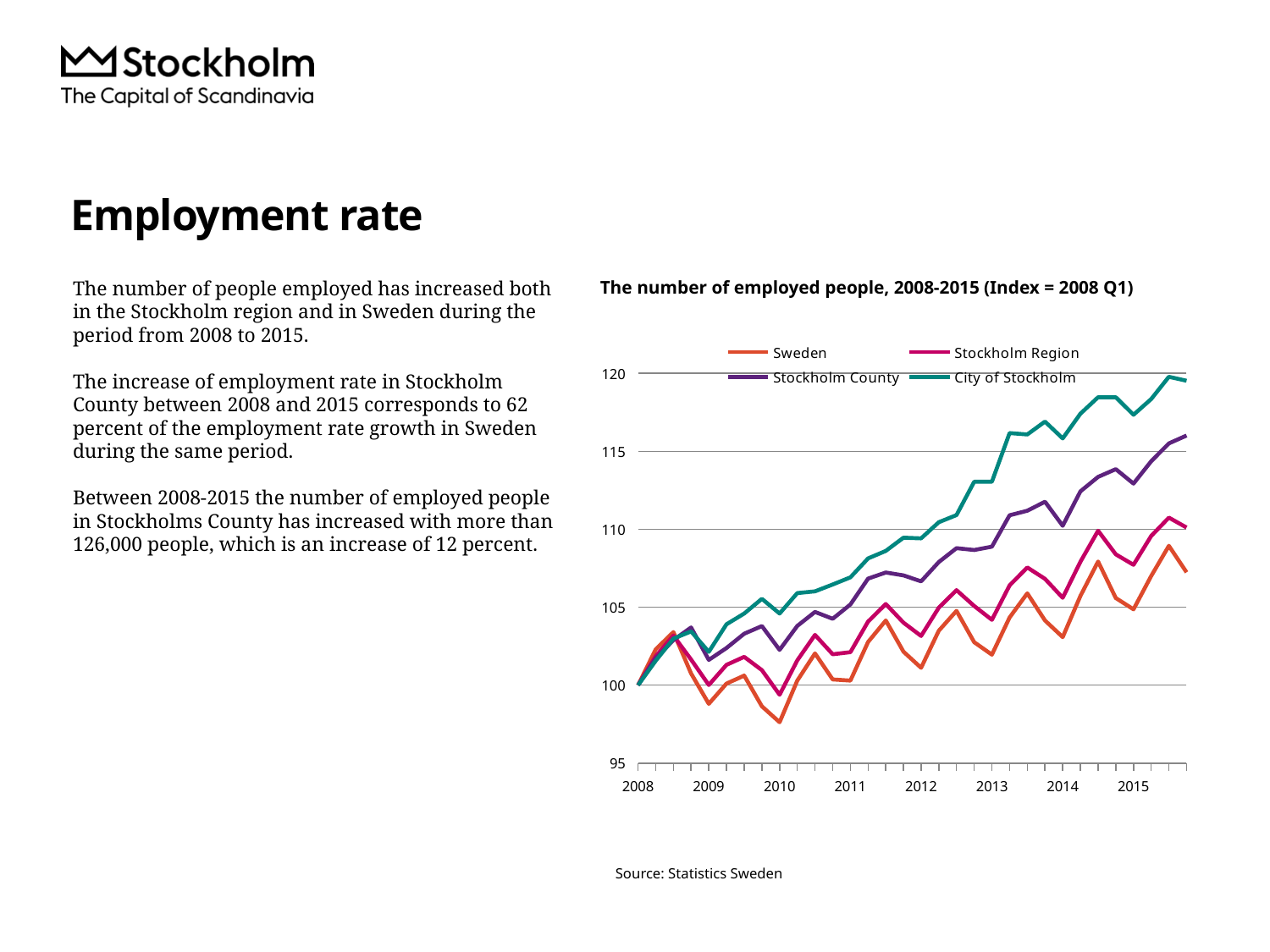
Is the value for Stockholm County at the end of 2015 greater or less than 115? greater At the start of 2014, which is higher: Stockholm County or Stockholm Region? Stockholm County What is the source cited below the chart? Statistics Sweden Is the value for City of Stockholm at the end of 2015 greater or less than 115? greater What is the title of the chart? The number of employed people, 2008-2015 (Index = 2008 Q1) Which series has the highest value at the end of 2015? City of Stockholm How many series does the chart's legend list? 4 What is the index value of all four series at the start of 2008? 100 Overall, does the City of Stockholm series rise or fall from 2008 to 2015? rise Is the value for Sweden at the start of 2010 greater or less than 100? less What kind of chart is shown on the slide? line chart Which series has the lowest value at the end of 2015? Sweden